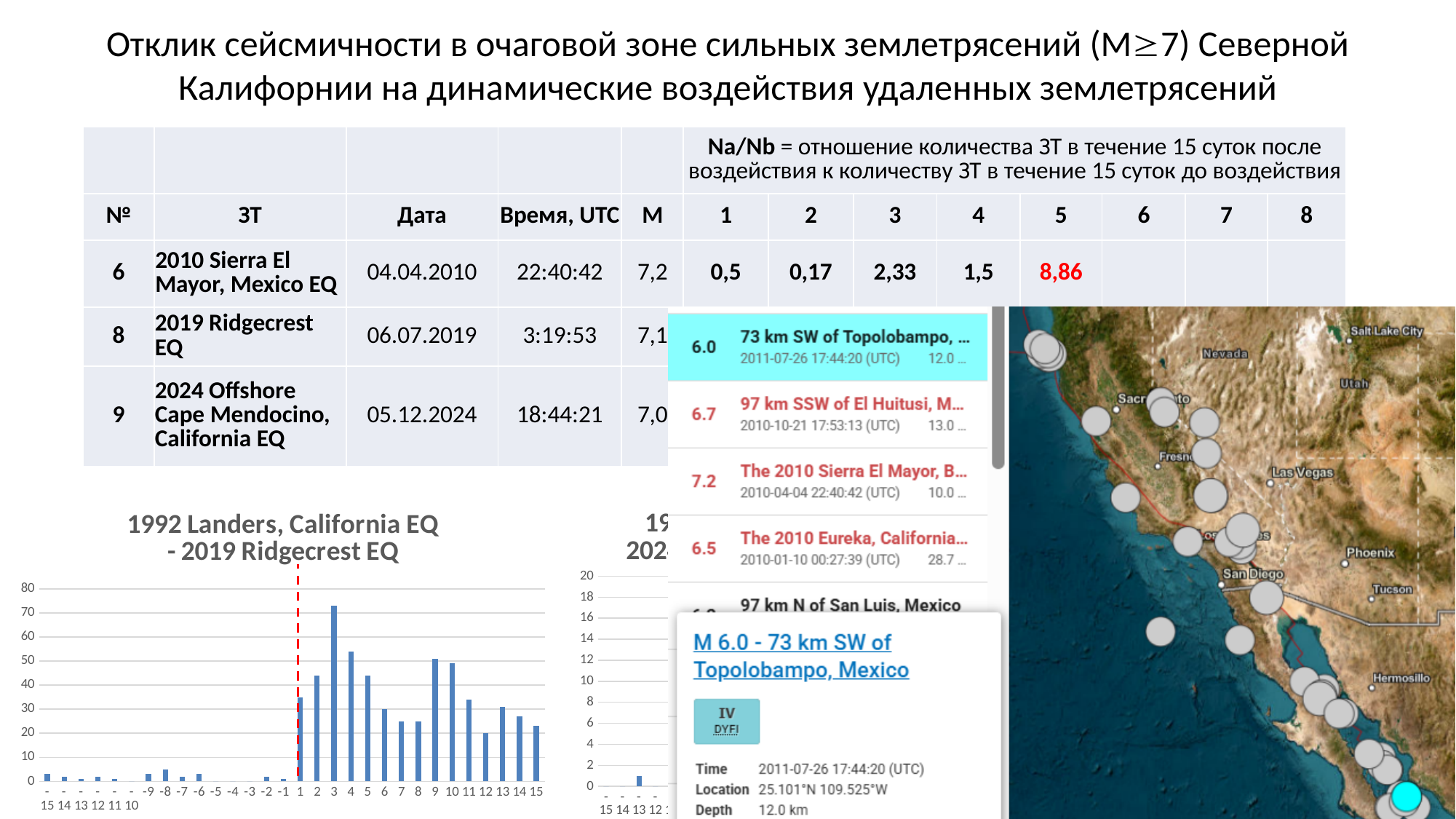
What is the highest tick value shown on the y axis of the chart titled "1992 Landers, California EQ - 2019 Ridgecrest EQ"? 80 In the chart titled "1992 Landers, California EQ - 2019 Ridgecrest EQ", which is larger, the value for day 3 or the value for day 4? day 3 In the chart titled "1992 Landers, California EQ - 2019 Ridgecrest EQ", which is larger, the value for day 9 or the value for day 7? day 9 In the chart titled "1992 Landers, California EQ - 2019 Ridgecrest EQ", is the value for day -8 greater or less than 10? less What kind of chart is the chart titled "1992 Landers, California EQ - 2019 Ridgecrest EQ"? bar chart What colour is the dashed vertical line in the chart titled "1992 Landers, California EQ - 2019 Ridgecrest EQ"? red In the chart titled "1992 Landers, California EQ - 2019 Ridgecrest EQ", is the value for day 1 greater or less than 40? less In the chart titled "1992 Landers, California EQ - 2019 Ridgecrest EQ", is the value for day 12 greater or less than 30? less In the chart titled "1992 Landers, California EQ - 2019 Ridgecrest EQ", which day on the x axis has the highest bar? 3 In the chart titled "1992 Landers, California EQ - 2019 Ridgecrest EQ", are the bars for the days before the red dashed line generally higher or lower than the bars after it? lower